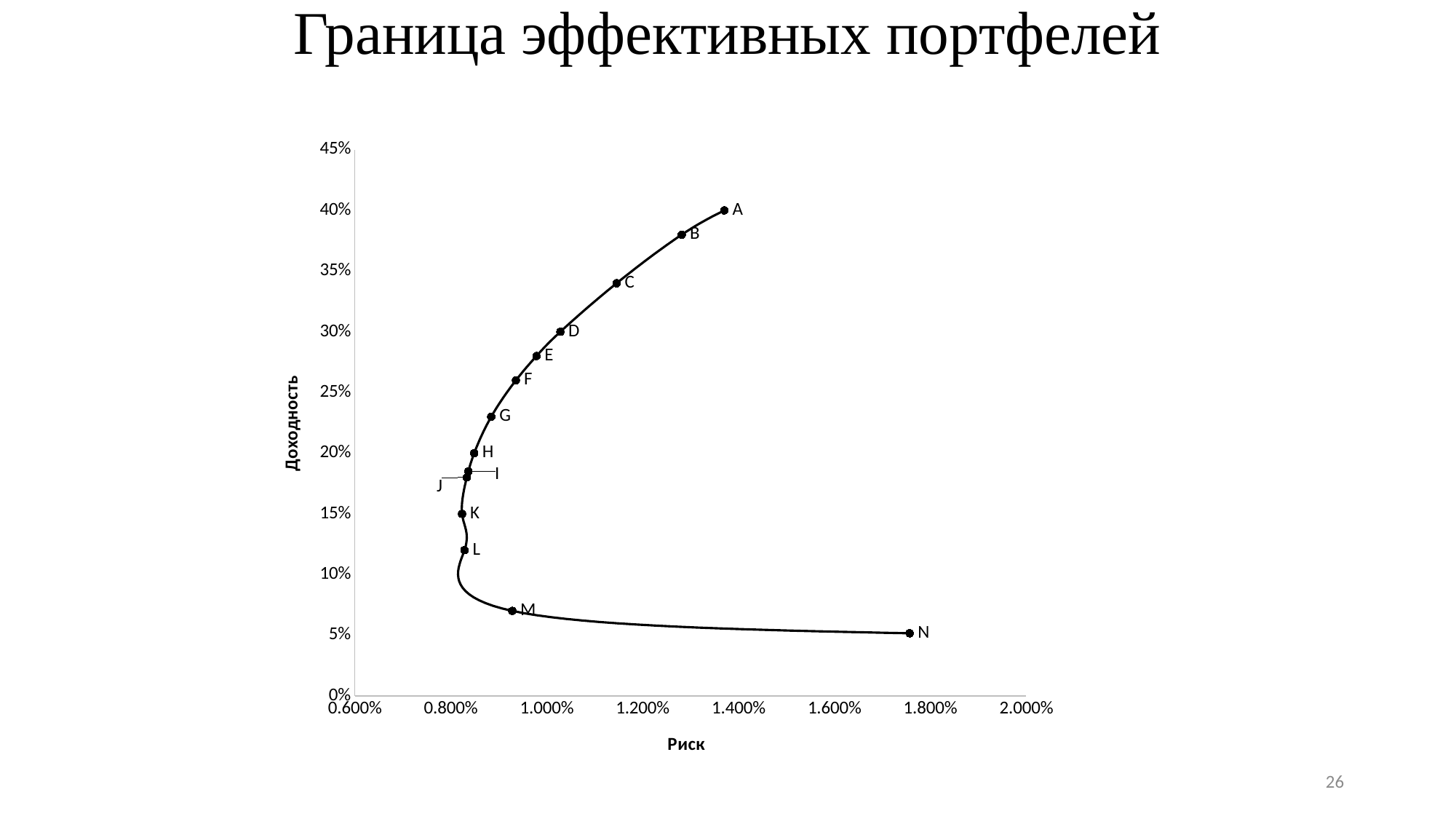
What kind of chart is shown on the slide? Scatter chart with a smooth line What is the Доходность value for point H? 20% What is the Доходность value for point D? 30% What is the title of the chart on the slide? Граница эффективных портфелей What is the Доходность value for point A? 40% Which point has a higher Доходность value, point F or point G? F Which point has the highest value on the Риск axis? N Is the Риск value for point N greater or less than 1.600%? greater How many labelled points are plotted on the chart? 14 Which point has the highest value on the Доходность axis? A Is the Доходность value for point C greater or less than 30%? greater Which point has the lowest value on the Доходность axis? N